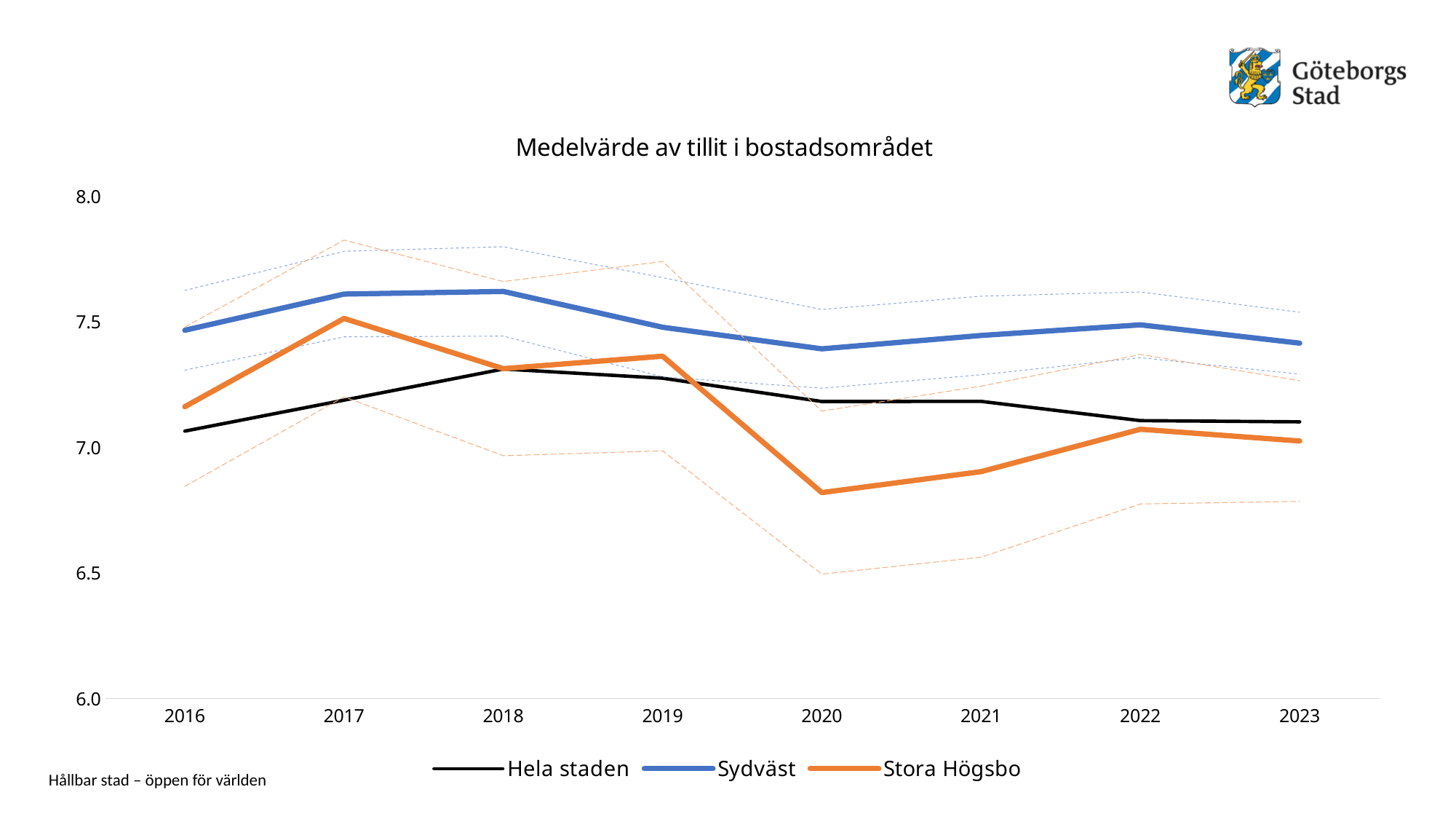
Is the value for Sydväst in 2020 greater or less than 7.5? less How many years are shown on the x axis? 8 Is the value for Sydväst in 2018 greater or less than 7.5? greater In 2017, which is larger: Hela staden or Stora Högsbo? Stora Högsbo Is the value for Stora Högsbo in 2020 greater or less than 7.0? less What is the title of the chart? Medelvärde av tillit i bostadsområdet In which year is Stora Högsbo at its lowest? 2020 In which year is Stora Högsbo at its highest? 2017 How many series does the legend list? 3 What kind of chart is shown on the slide? line chart Which series is drawn in orange? Stora Högsbo In 2020, which is larger: Sydväst or Stora Högsbo? Sydväst